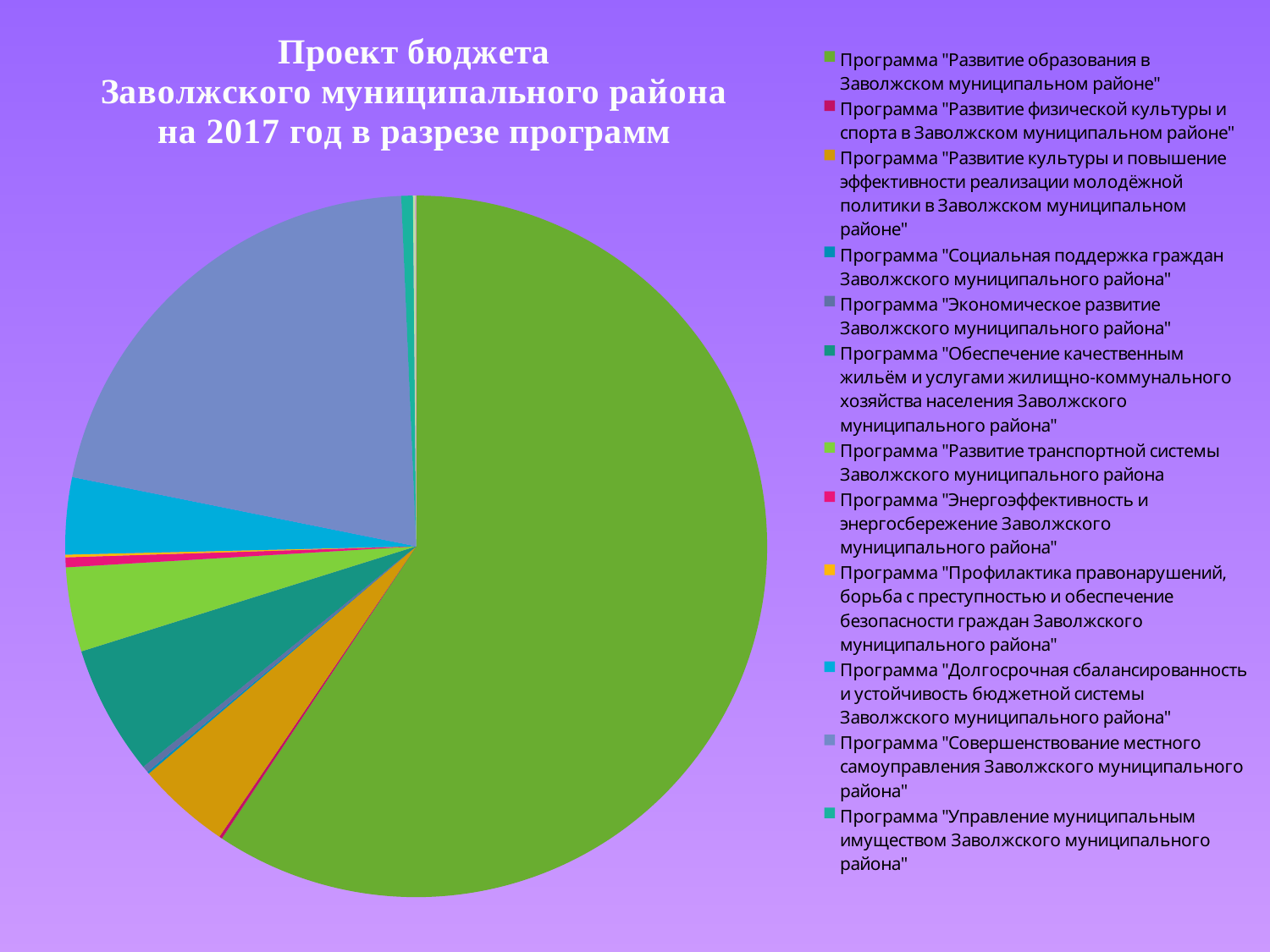
What kind of chart is shown on the slide? pie chart Which slice is larger: Программа "Социальная поддержка граждан Заволжского муниципального района" or Программа "Энергоэффективность и энергосбережение Заволжского муниципального района"? Программа "Энергоэффективность и энергосбережение Заволжского муниципального района" What is the title of the chart? Проект бюджета Заволжского муниципального района на 2017 год в разрезе программ Which slice is larger: the one for Программа "Развитие образования в Заволжском муниципальном районе" or the one for Программа "Экономическое развитие Заволжского муниципального района"? Программа "Развитие образования в Заволжском муниципальном районе" What colour is the largest slice of the pie chart? green How many programs does the legend of the pie chart list? 12 Does the slice for Программа "Развитие образования в Заволжском муниципальном районе" take up more or less than half of the pie? more Which slice is larger: Программа "Экономическое развитие Заволжского муниципального района" or Программа "Развитие культуры и повышение эффективности реализации молодёжной политики в Заволжском муниципальном районе"? Программа "Развитие культуры и повышение эффективности реализации молодёжной политики в Заволжском муниципальном районе" Which program has the largest slice of the pie chart? Программа "Развитие образования в Заволжском муниципальном районе"